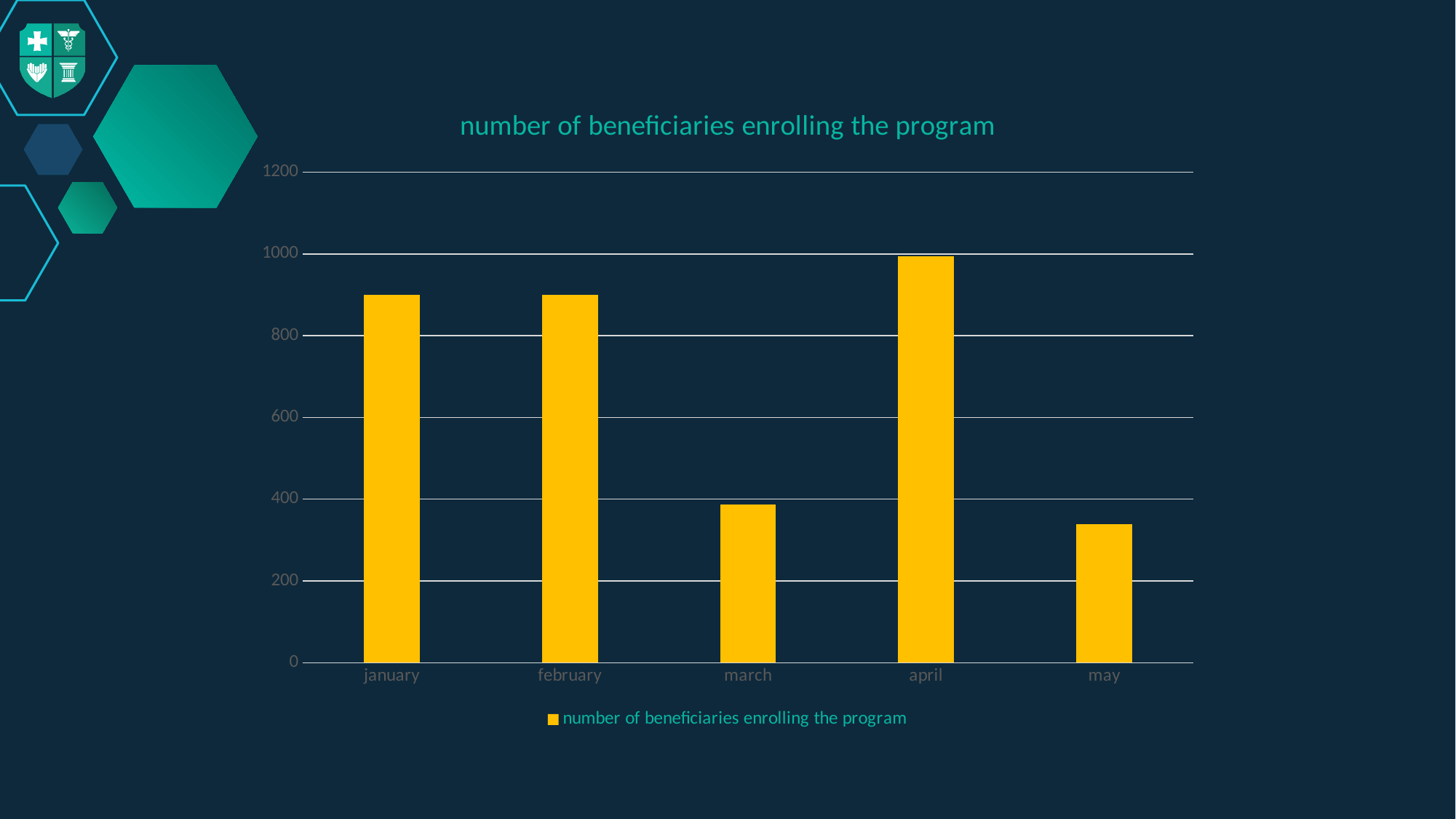
How many months are shown on the x axis of the chart? 5 Which month has the lowest number of beneficiaries enrolling the program? may Which month has the highest number of beneficiaries enrolling the program? april Is the value for may greater or less than 400? less Is the value for april greater or less than 800? greater Does the value rise or fall from april to may? fall Which has a larger value, april or march? april How many series does the chart legend list? 1 Is the value for january greater or less than 800? greater What kind of chart is shown on the slide? bar chart What is the title of the chart? number of beneficiaries enrolling the program